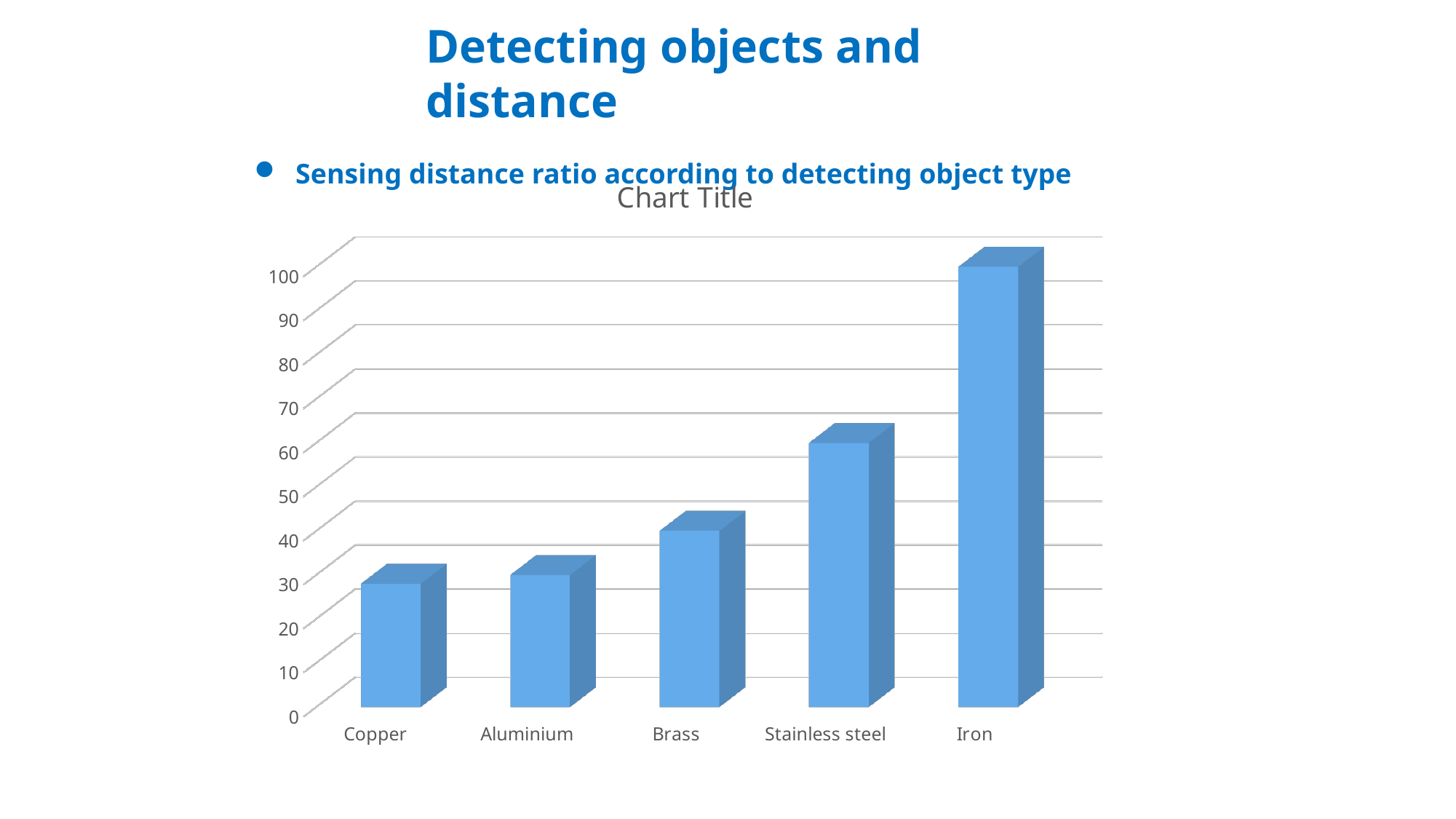
Which is larger, the value for Brass or the value for Copper? Brass What title is printed above the chart? Chart Title Is the value for Brass greater or less than 60? less Is the value for Stainless steel greater or less than 50? greater What kind of chart is shown on the slide? bar chart Do the values rise or fall moving from Copper to Iron along the x axis? rise Is the value for Copper greater or less than 50? less How many object types (categories) are plotted on the chart? 5 Which object type has the highest sensing distance ratio? Iron Which is larger, the value for Stainless steel or the value for Brass? Stainless steel Which is larger, the value for Iron or the value for Stainless steel? Iron